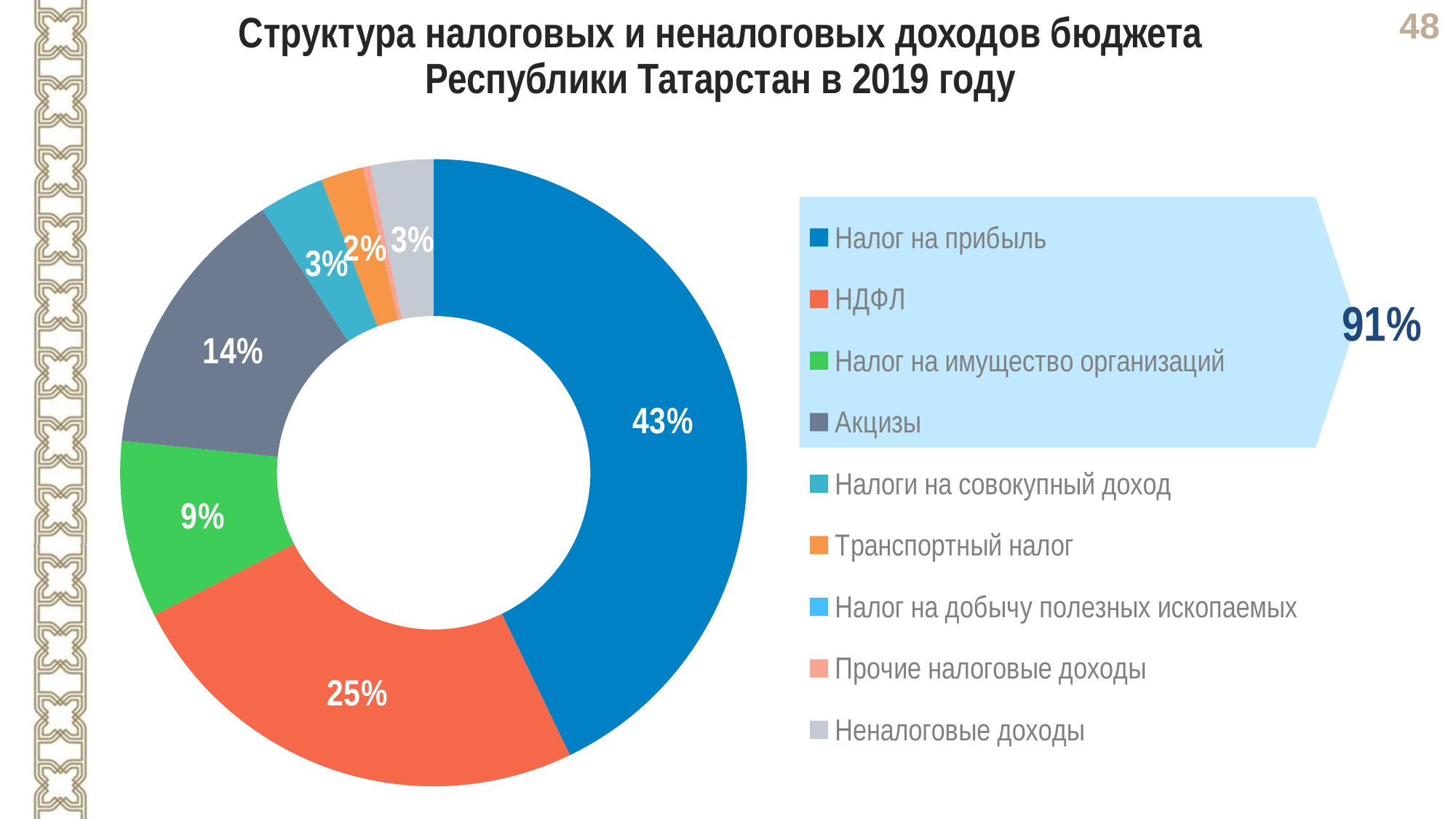
What combined percentage is shown in the highlighted box next to the first four legend entries? 91% What percentage is shown for Неналоговые доходы? 3% What share is shown for Транспортный налог? 2% What share of the budget revenue does Налог на прибыль account for? 43% Which category has the largest share of the chart? Налог на прибыль What share is shown for Акцизы? 14% Which is larger: the share for Акцизы or for Налог на имущество организаций? Акцизы What percentage does Налог на имущество организаций represent? 9% How many categories does the legend list? 9 By how many percentage points does Налог на прибыль exceed НДФЛ? 18 percentage points What type of chart is shown on the slide? Pie (donut) chart What percentage is shown for НДФЛ? 25%